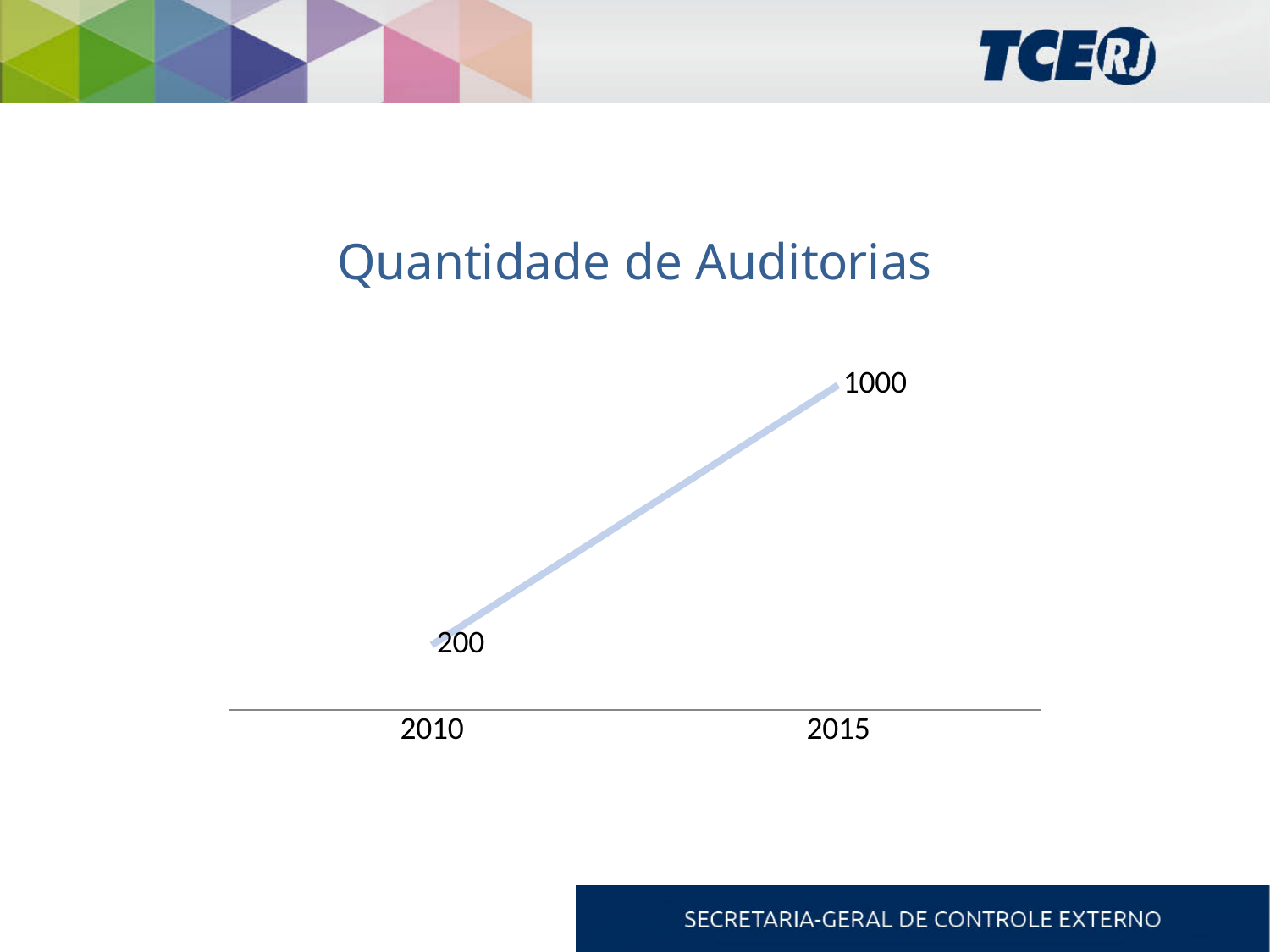
Which year has the highest value? 2015 What is the title of the chart? Quantidade de Auditorias How many data points are plotted on the chart? 2 What kind of chart is shown on the slide? line chart What is the value for 2010? 200 What is the difference between the values for 2015 and 2010? 800 Which is larger, the value for 2010 or the value for 2015? 2015 What is the value for 2015? 1000 Which year has the lowest value? 2010 Do the values rise or fall from 2010 to 2015? rise What are the two categories shown on the x axis? 2010 and 2015